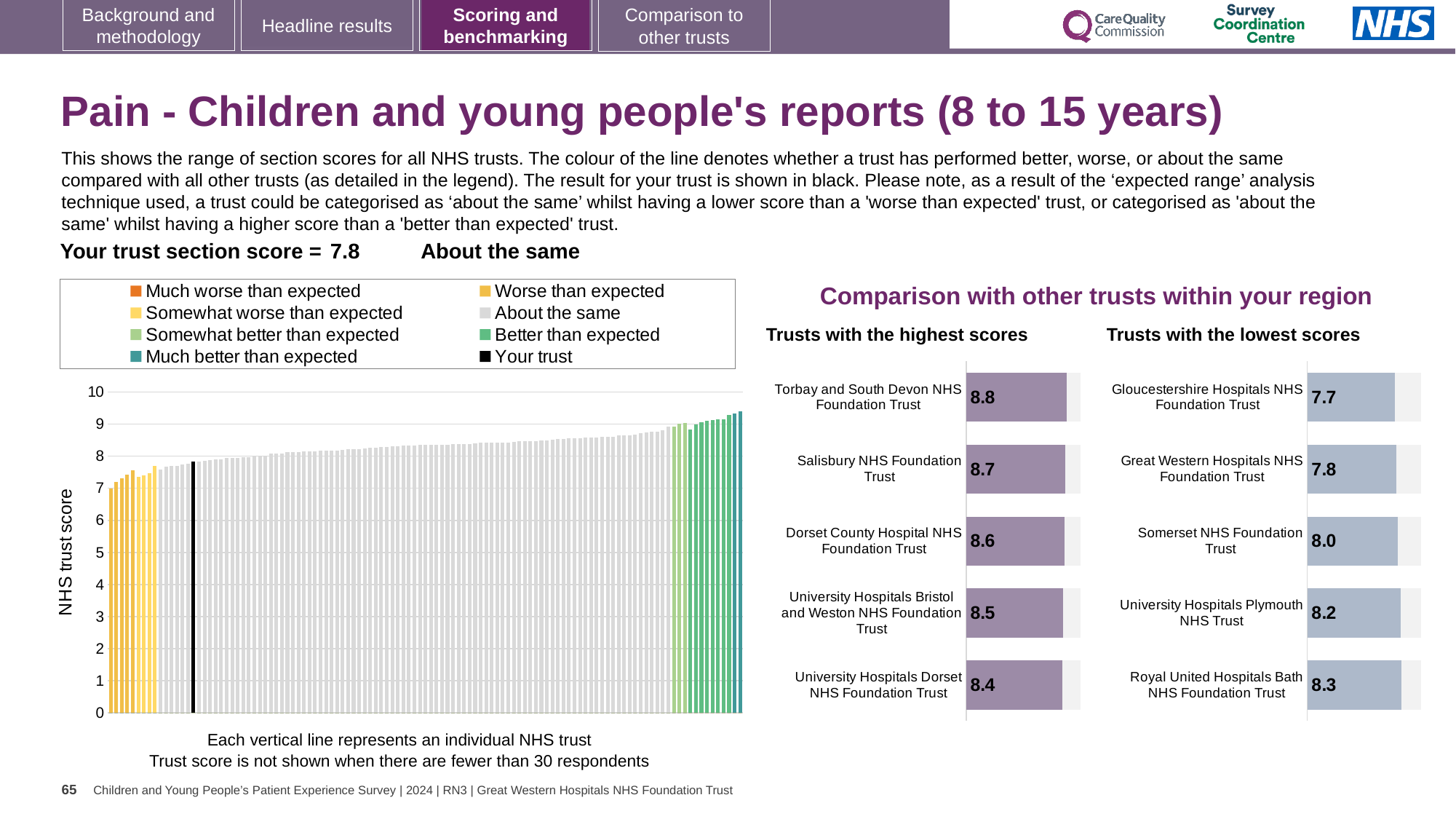
In the 'Trusts with the lowest scores' chart, what is the difference between the scores of Royal United Hospitals Bath NHS Foundation Trust and Gloucestershire Hospitals NHS Foundation Trust? 0.6 In the 'Trusts with the highest scores' chart, what is the score for University Hospitals Dorset NHS Foundation Trust? 8.4 In the 'Trusts with the lowest scores' chart, which has the larger score: Somerset NHS Foundation Trust or University Hospitals Plymouth NHS Trust? University Hospitals Plymouth NHS Trust In the large chart on the left, do the trust scores rise or fall from left to right? Rise How many entries does the legend of the large chart on the left list? 8 What kind of chart is the large chart on the left showing NHS trust scores? Bar chart In the 'Trusts with the highest scores' chart, what is the difference between the scores of Torbay and South Devon NHS Foundation Trust and Dorset County Hospital NHS Foundation Trust? 0.2 In the 'Trusts with the highest scores' chart, what is the score for Torbay and South Devon NHS Foundation Trust? 8.8 How many trusts are shown in the 'Trusts with the lowest scores' chart? 5 In the 'Trusts with the lowest scores' chart, which trust has the lowest score? Gloucestershire Hospitals NHS Foundation Trust In the 'Trusts with the lowest scores' chart, what is the score for Somerset NHS Foundation Trust? 8.0 In the 'Trusts with the highest scores' chart, which trust has the highest score? Torbay and South Devon NHS Foundation Trust